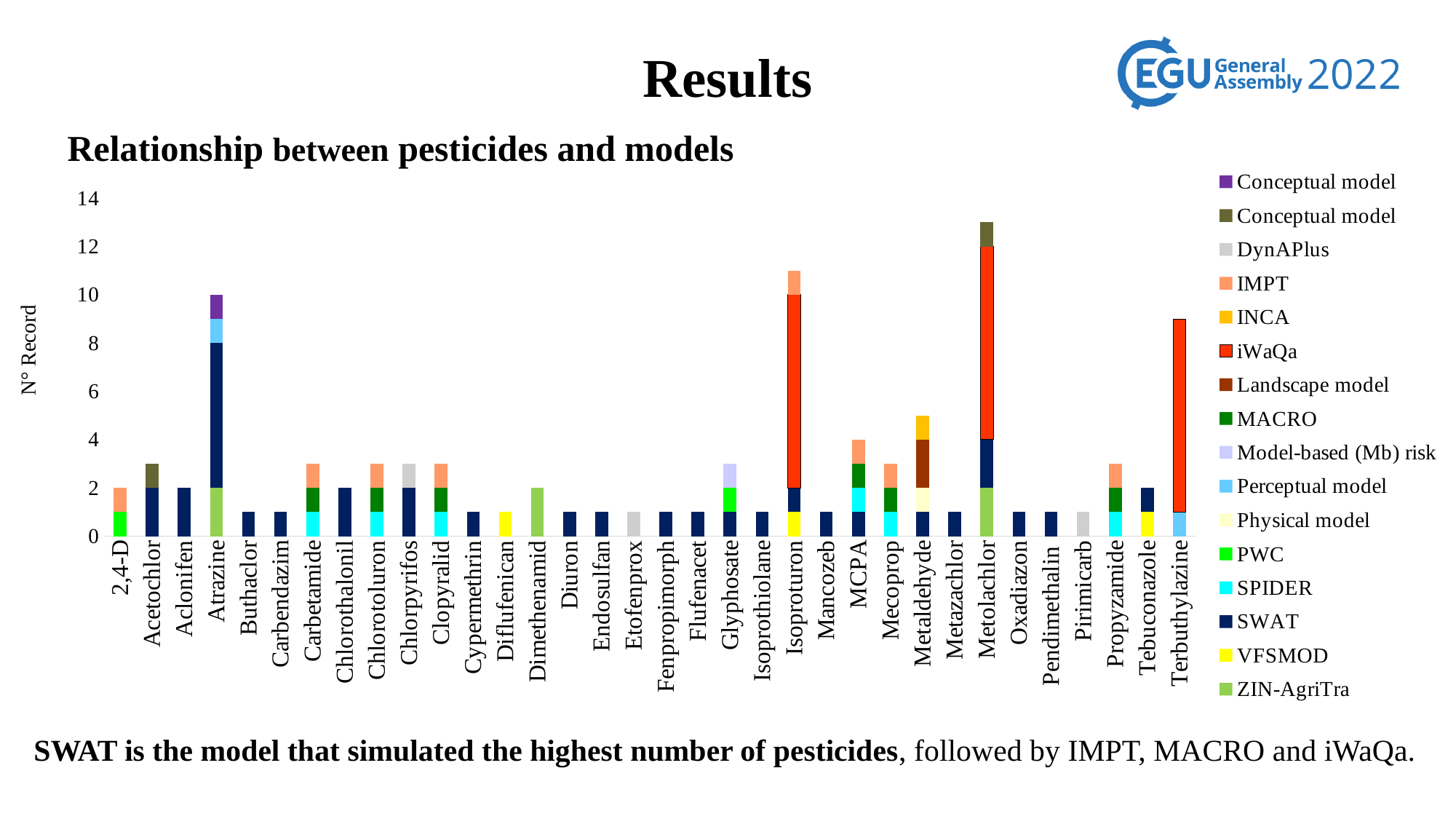
What is the title of the chart? Relationship between pesticides and models What is the label of the vertical axis? N° Record Is the total value for Isoproturon greater or less than 10? greater Which pesticide has the highest total number of records? Metolachlor How many entries does the legend list? 16 What kind of chart is shown on the slide? Stacked bar chart How many pesticides are shown on the x axis? 34 What is the total number of records for Atrazine? 10 Is the total value for Metolachlor greater or less than 12? greater Is the total value for Terbuthylazine greater or less than 10? less Which has more records, Isoproturon or Terbuthylazine? Isoproturon What is the total number of records for Aclonifen? 2